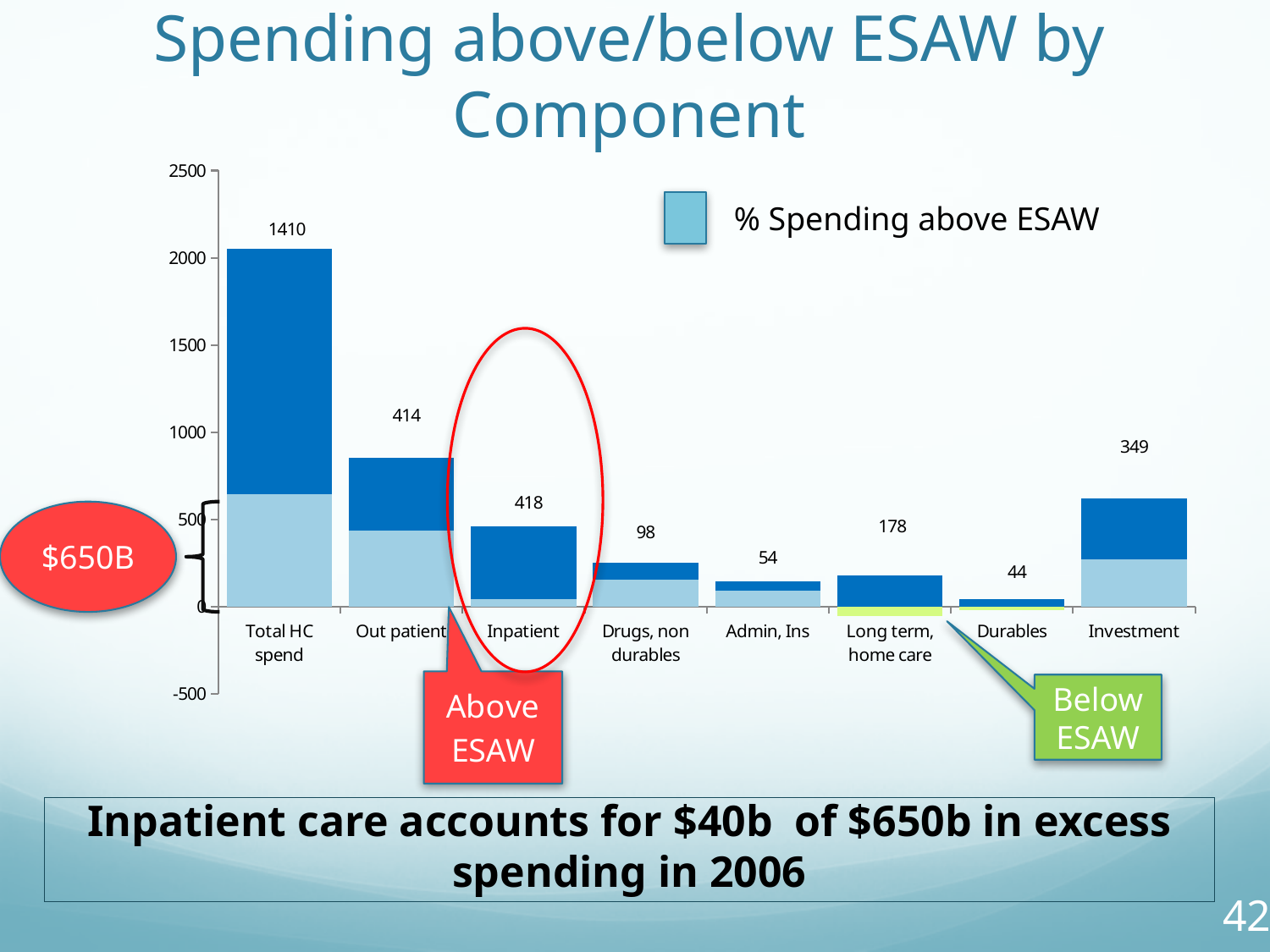
What is the legend entry shown on the chart? % Spending above ESAW What value is labelled for the Long term, home care bar? 178 What kind of chart is shown on the slide? Bar chart Which category has the highest labelled value? Total HC spend How many categories are shown on the x axis? 8 How many series does the legend list? 1 What value is labelled for the Investment bar? 349 Which category has the lowest labelled value? Durables Which has the larger labelled value, Investment or Long term, home care? Investment What value is labelled for the Inpatient bar? 418 What is the difference between the labelled values for Inpatient and Out patient? 4 Is the top of the Out patient bar greater or less than 1000? less